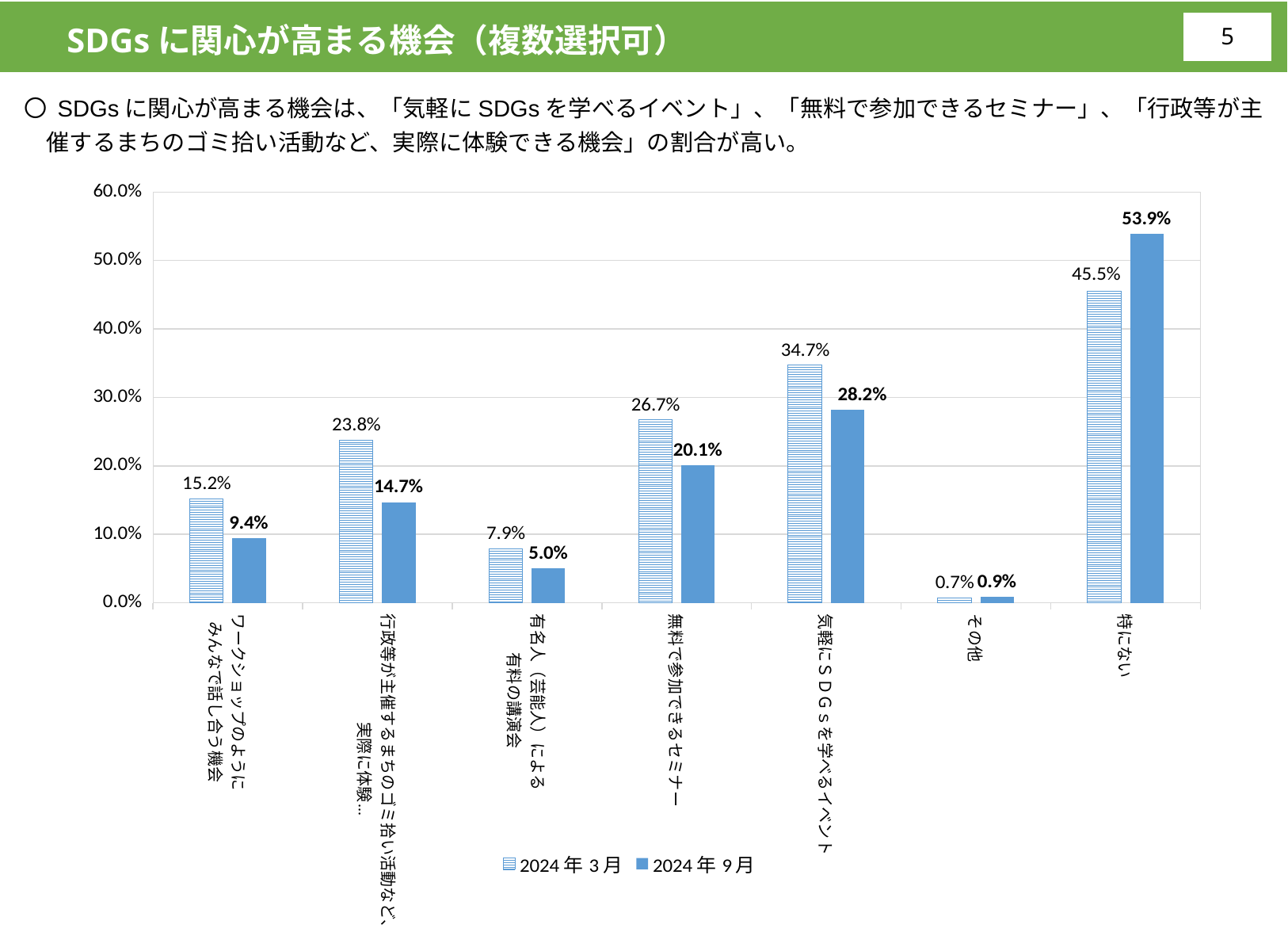
このグラフの種類は何ですか？ 棒グラフ 2024年9月の系列で最も値が高い項目はどれですか？ 特にない 凡例に示されている系列はいくつありますか？ 2 「ワークショップのようにみんなで話し合う機会」では、2024年3月と2024年9月のどちらの値が大きいですか？ 2024年3月 「無料で参加できるセミナー」の2024年3月の値はいくつですか？ 26.7% 2024年3月の系列で最も値が低い項目はどれですか？ その他 「気軽にSDGsを学べるイベント」の2024年3月の値は30.0%より大きいですか、小さいですか？ 大きい 「気軽にSDGsを学べるイベント」の2024年9月の値はいくつですか？ 28.2% このグラフには項目（カテゴリ）がいくつありますか？ 7 「有名人（芸能人）による有料の講演会」の2024年9月の値はいくつですか？ 5.0% 「特にない」の2024年9月と2024年3月の値の差はいくつですか？ 8.4% 凡例に示されている2つの系列の名前は何ですか？ 2024年3月、2024年9月